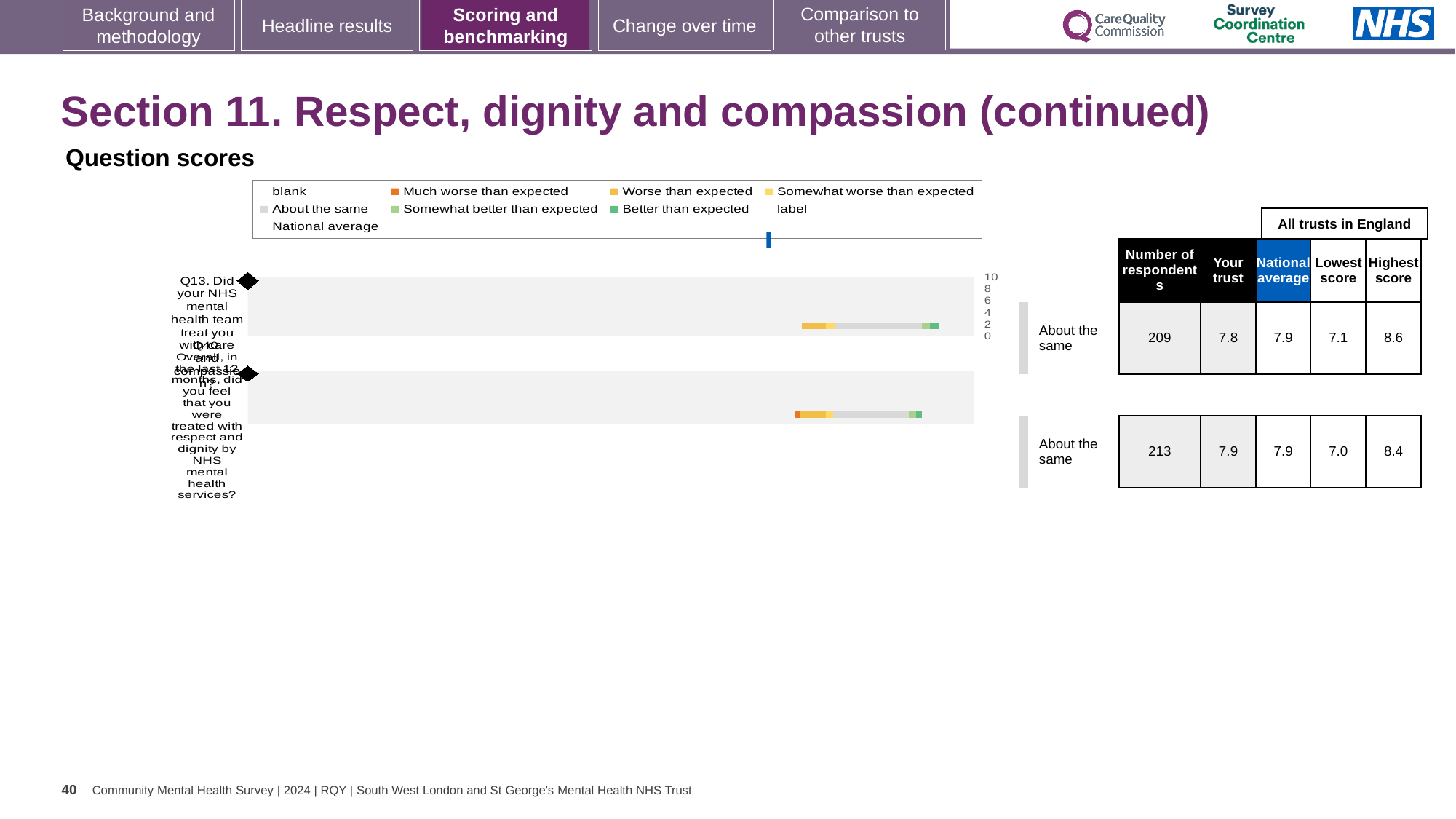
What is the 'Your trust' score for Q13 (Did your NHS mental health team treat you with care and compassion?)? 7.8 How many respondents answered Q14 (treated with respect and dignity by NHS mental health services)? 213 What is the difference between the highest and lowest trust scores for Q14? 1.4 What benchmark category is shown for Q14? About the same What is the highest score among all trusts in England for Q14? 8.4 For Q13, which is larger: the 'Your trust' score or the national average? National average What is the lowest score among all trusts in England for Q13? 7.1 What is the difference between the highest and lowest trust scores for Q13? 1.5 What is the national average score for Q13? 7.9 How many respondents answered Q13? 209 Which question has the higher 'Highest score' across all trusts in England, Q13 or Q14? Q13 How many questions are plotted in the chart? 2